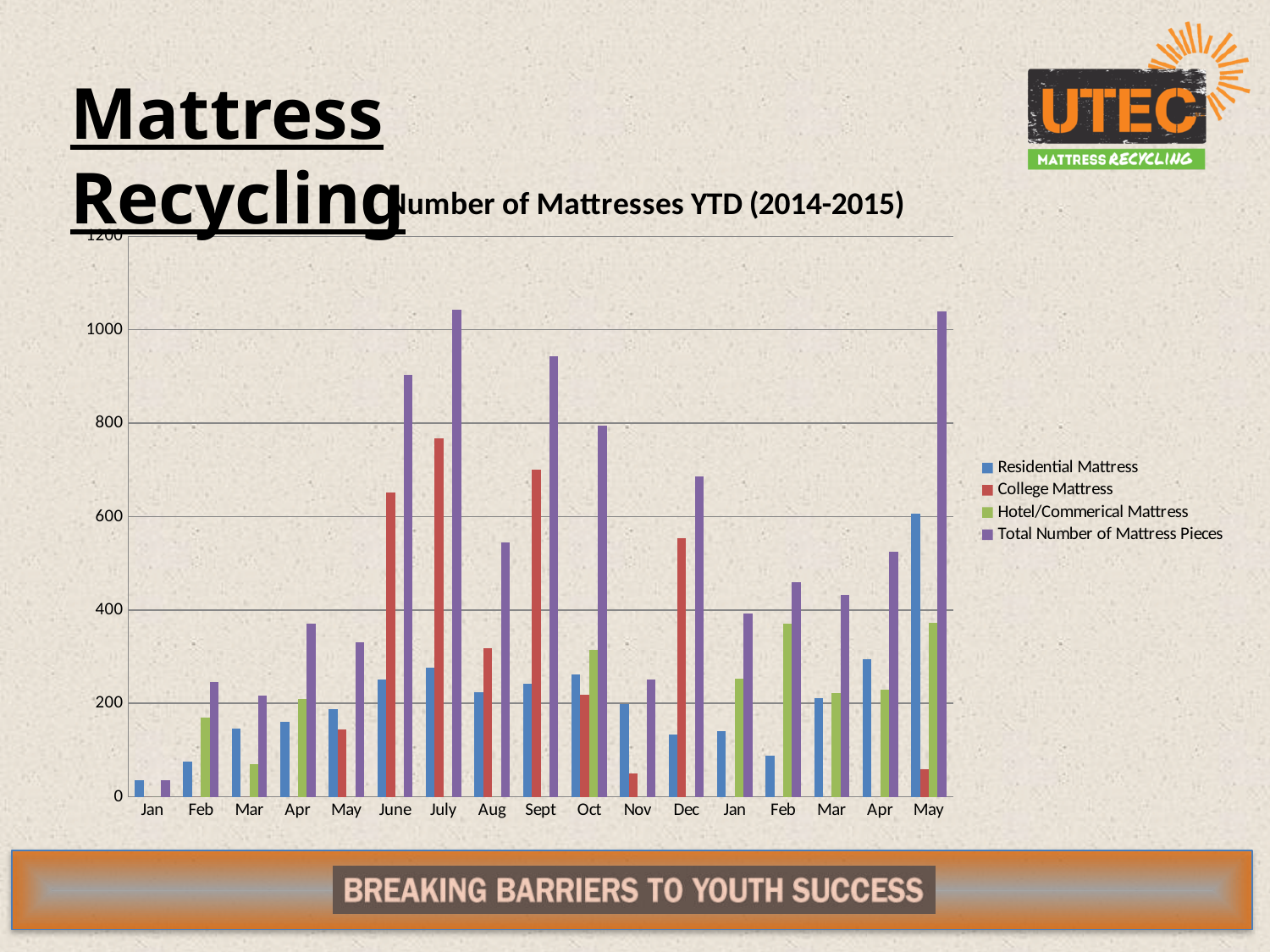
Which is larger, the Residential Mattress value for Oct or for Dec? Oct What is the title of the chart? Number of Mattresses YTD (2014-2015) In which month is the College Mattress value highest? July Which colour represents the Total Number of Mattress Pieces series? purple Does the Total Number of Mattress Pieces rise or fall from Jan to July? rise Is the Total Number of Mattress Pieces for Nov greater or less than 400? less How many series does the legend list? 4 In which month is the Total Number of Mattress Pieces lowest? Jan (first) What kind of chart is shown on the slide? bar chart How many month categories are shown along the x axis? 17 Is the College Mattress value for June greater or less than 600? greater Is the Total Number of Mattress Pieces for July greater or less than 1000? greater